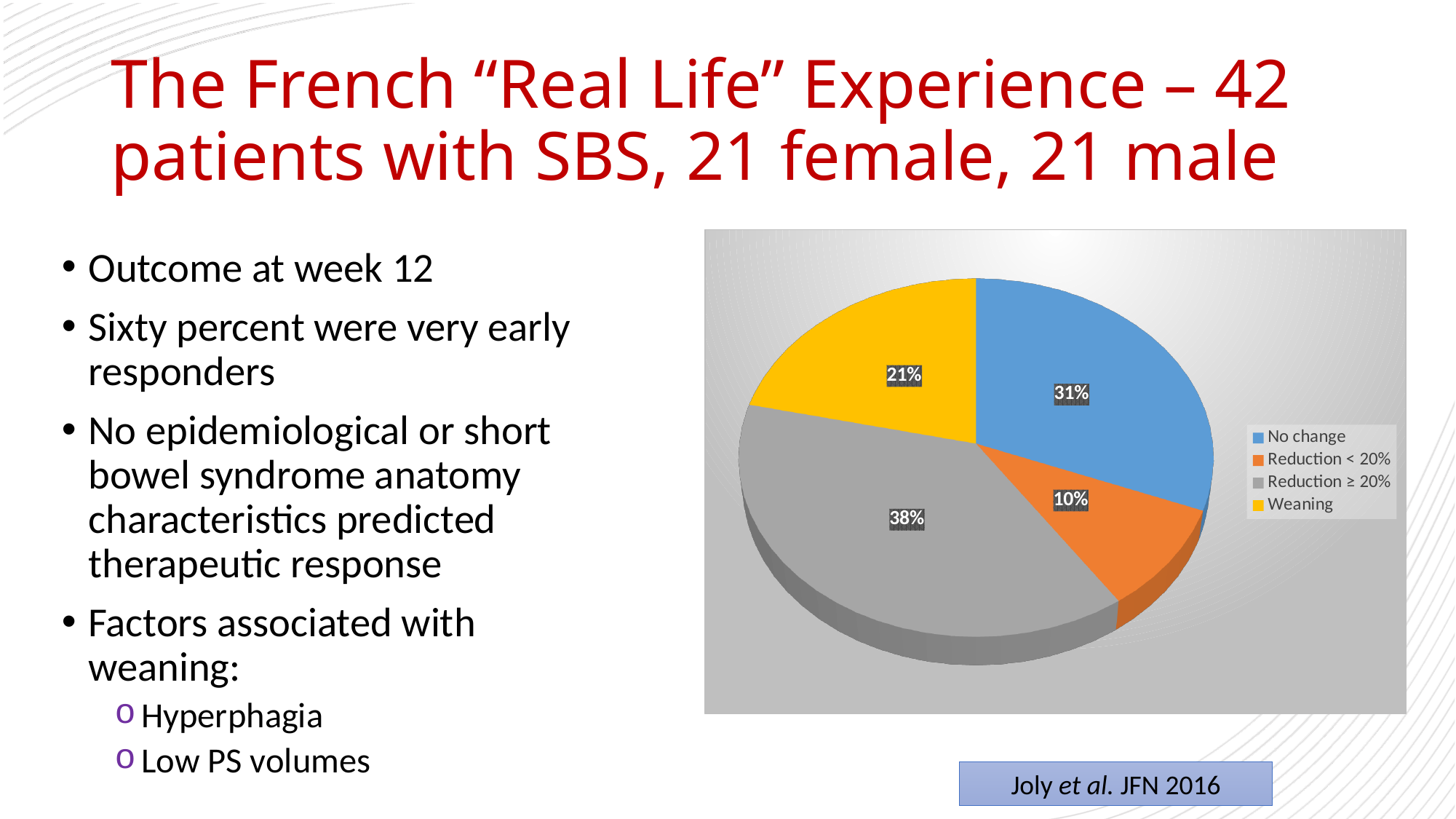
Which category has the smallest slice of the pie chart? Reduction < 20% How many slices does the pie chart have? 4 What percentage of the pie chart is labelled "Reduction < 20%"? 10% Which category has the largest slice of the pie chart? Reduction ≥ 20% What percentage of the pie chart is labelled "No change"? 31% What percentage of the pie chart is labelled "Weaning"? 21% Which slice is larger, "Weaning" or "Reduction < 20%"? Weaning What is the difference in percentage points between the "Reduction ≥ 20%" slice and the "No change" slice? 7 What colour is the "Weaning" slice in the pie chart? Yellow What kind of chart is shown on the slide? Pie chart What percentage of the pie chart is labelled "Reduction ≥ 20%"? 38% What is the combined percentage of the two "Reduction" slices in the pie chart? 48%